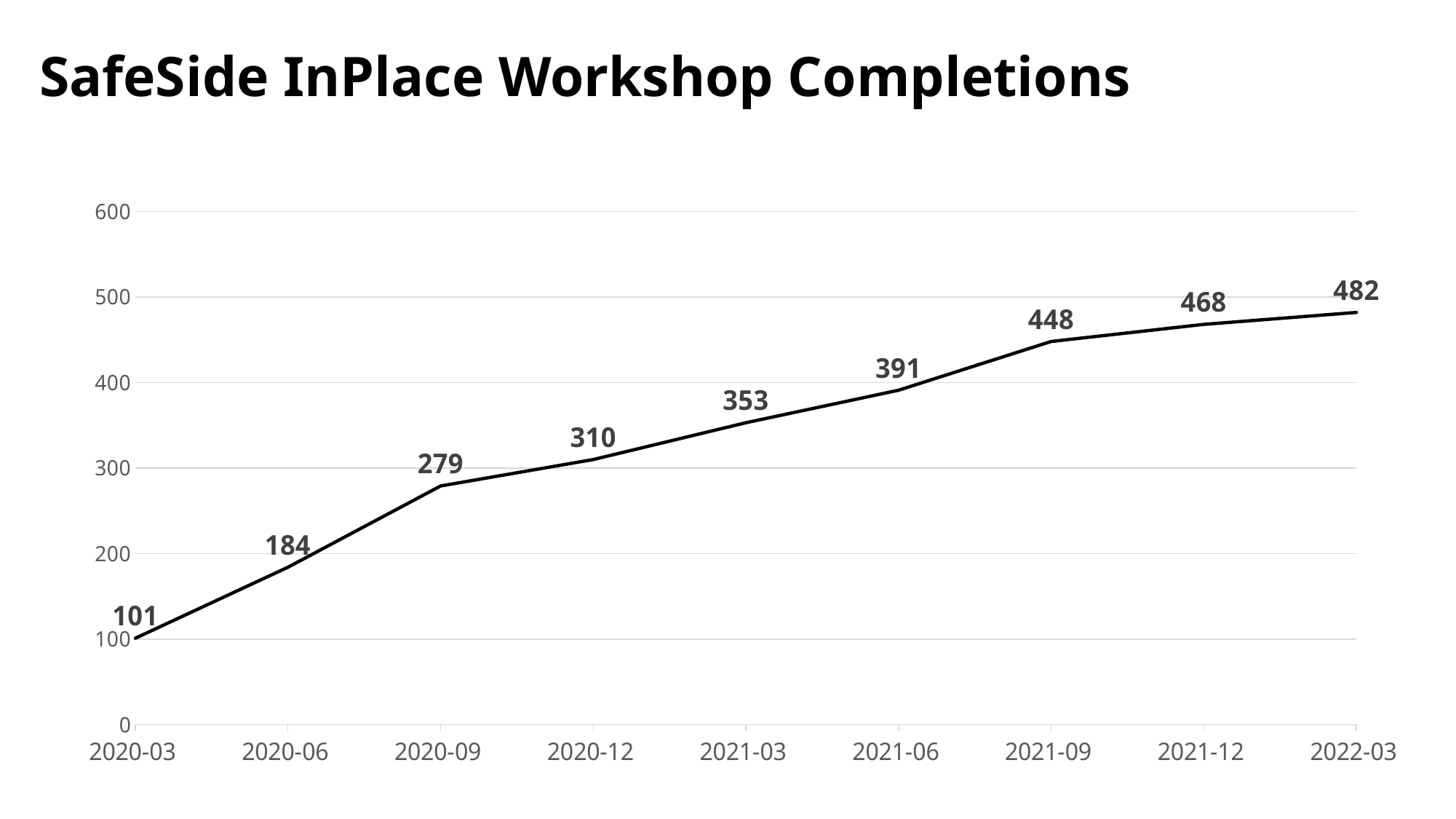
What is the difference between the values for 2021-09 and 2020-12? 138 How many data points are plotted on the chart? 9 Which date has the lowest value? 2020-03 Is the value for 2021-12 greater or less than 500? less What kind of chart is shown? line chart Which is larger, the value for 2020-06 or the value for 2021-03? 2021-03 What is the value for 2021-06? 391 Which date has the highest value? 2022-03 What is the value for 2022-03? 482 What is the title of the chart? SafeSide InPlace Workshop Completions Do the values rise or fall from 2020-03 to 2022-03? rise What is the value for 2020-09? 279